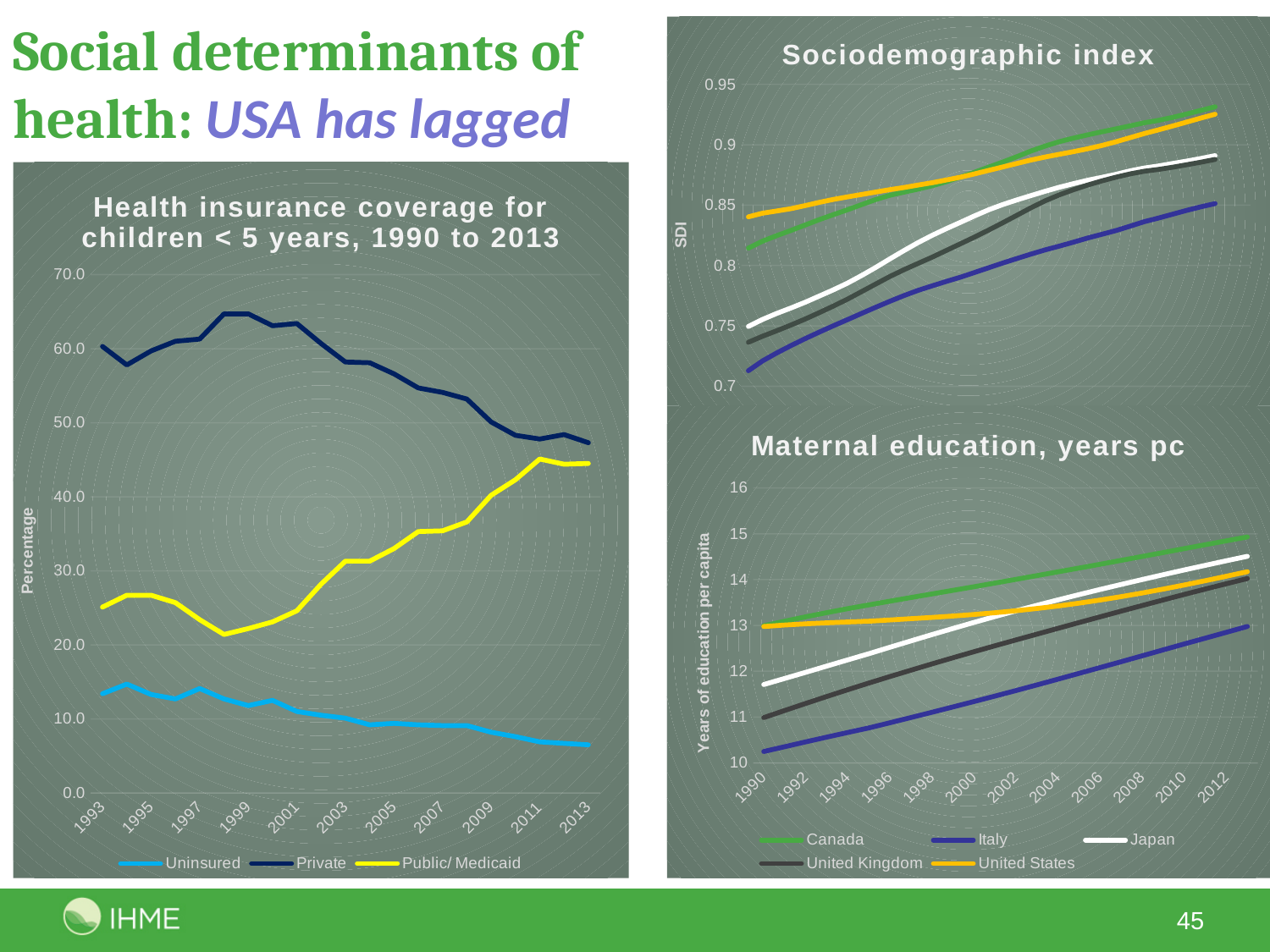
In the 'Health insurance coverage for children < 5 years' chart, is the Public/Medicaid value in 2013 greater or less than 40.0? greater In the 'Maternal education, years pc' chart, which is larger in 1990: Japan or United Kingdom? Japan In the 'Health insurance coverage for children < 5 years' chart, is the Uninsured value in 2013 greater or less than 10.0? less In the 'Health insurance coverage for children < 5 years' chart, does the Private series rise or fall from 1993 to 2013? fall How many countries does the legend of the 'Maternal education, years pc' chart list? 5 In the 'Maternal education, years pc' chart, which country has the highest value in 2012? Canada In the 'Health insurance coverage for children < 5 years' chart, which series has the highest value in 1993? Private What kind of chart is the 'Health insurance coverage for children < 5 years, 1990 to 2013' chart? line chart How many series does the legend of the 'Health insurance coverage for children < 5 years' chart list? 3